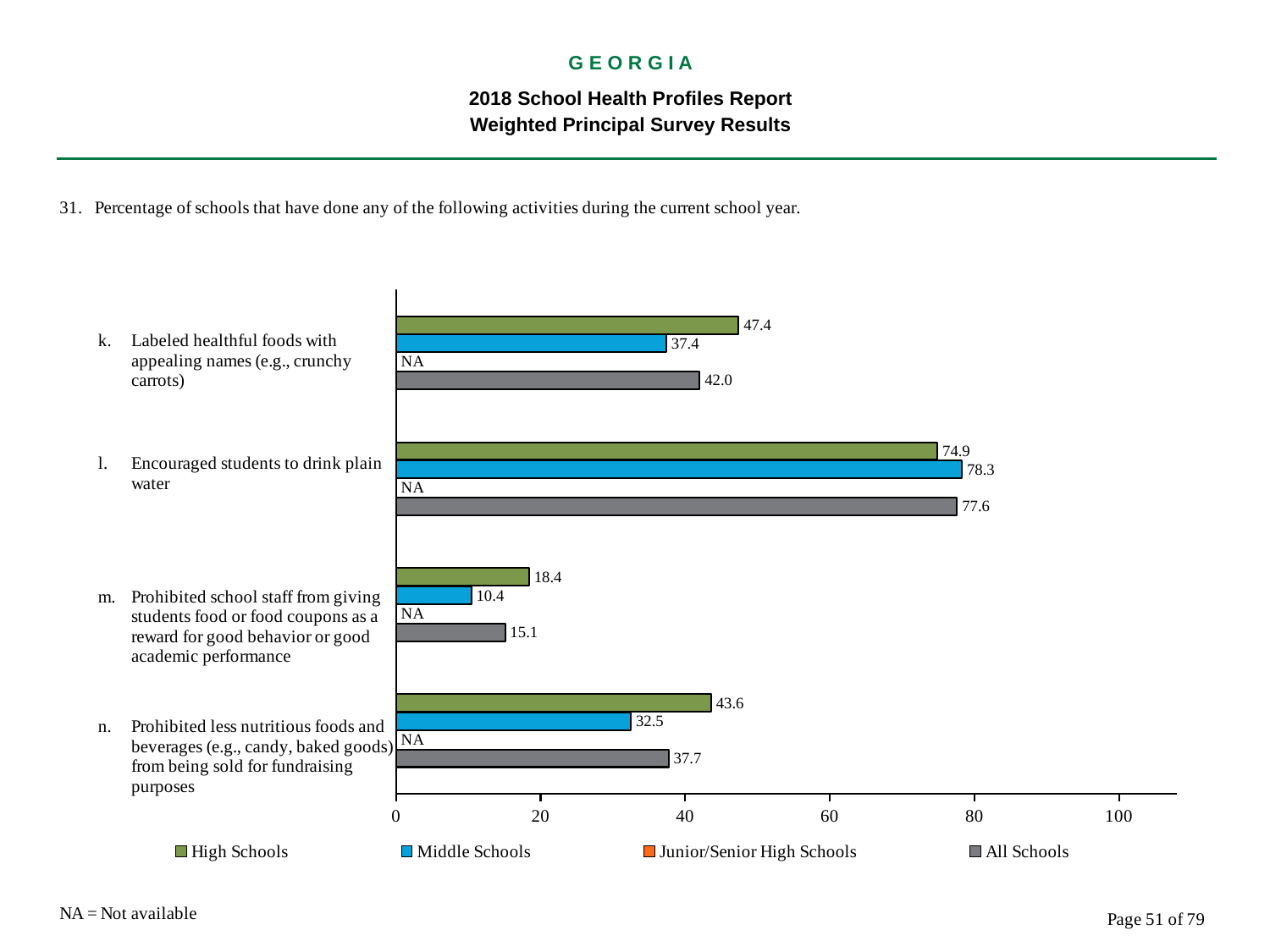
What is the value for High Schools for 'Encouraged students to drink plain water'? 74.9 What is the difference between the High Schools and Middle Schools values for 'Labeled healthful foods with appealing names (e.g., crunchy carrots)'? 10.0 For 'Encouraged students to drink plain water', which is larger: the High Schools value or the Middle Schools value? Middle Schools What is the value for All Schools for 'Prohibited school staff from giving students food or food coupons as a reward for good behavior or good academic performance'? 15.1 What is the value for Middle Schools for 'Prohibited less nutritious foods and beverages (e.g., candy, baked goods) from being sold for fundraising purposes'? 32.5 What kind of chart is shown on the slide? Bar chart Which activity has the highest value for All Schools? Encouraged students to drink plain water What is the value for Middle Schools for 'Labeled healthful foods with appealing names (e.g., crunchy carrots)'? 37.4 How many activities (categories) are shown on the chart? 4 Which activity has the lowest value for High Schools? Prohibited school staff from giving students food or food coupons as a reward for good behavior or good academic performance Is the All Schools value for 'Prohibited less nutritious foods and beverages (e.g., candy, baked goods) from being sold for fundraising purposes' greater or less than 40? less How many series does the legend list? 4